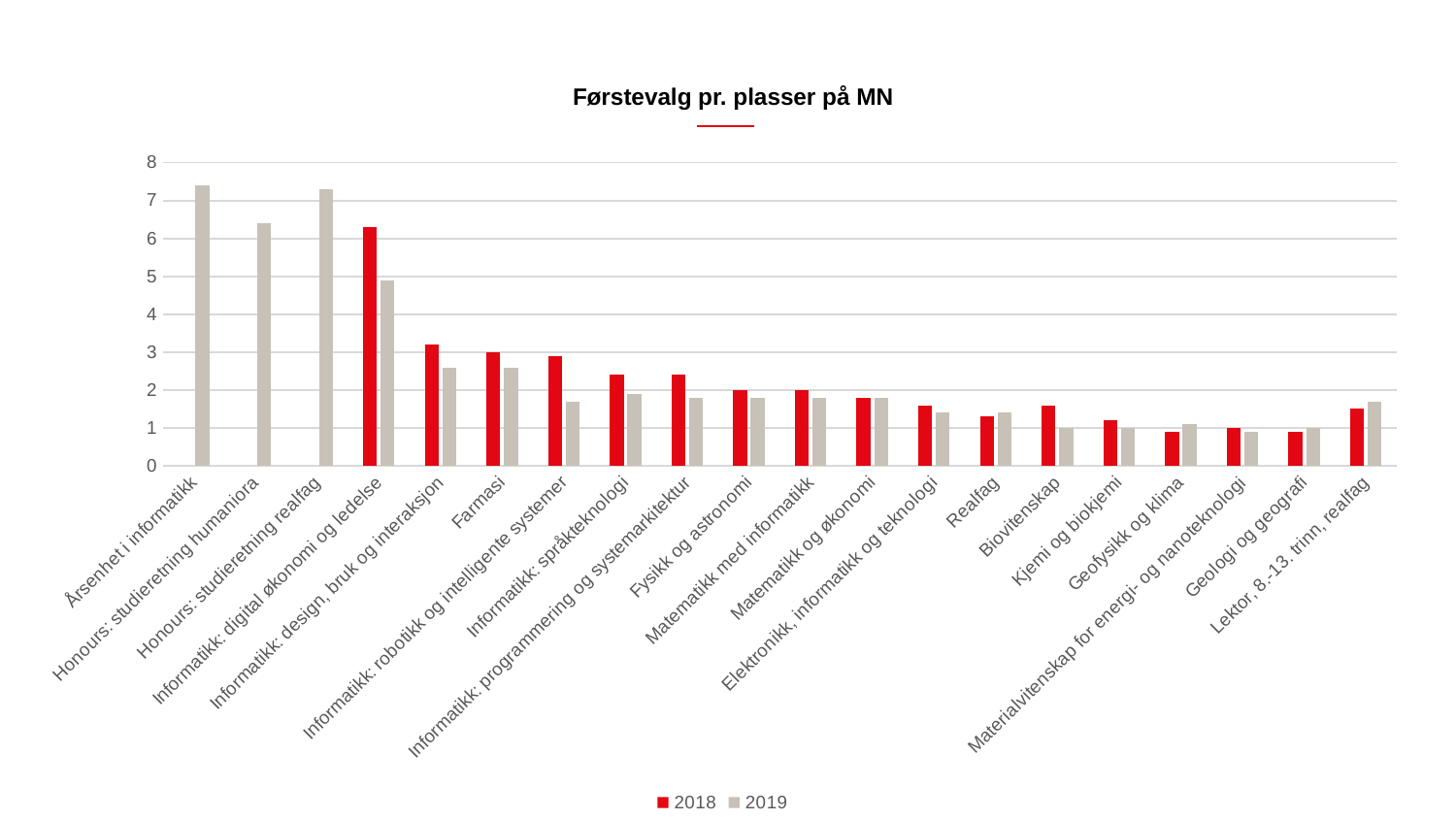
How many series does the legend list? 2 For Informatikk: robotikk og intelligente systemer, which year has the larger value, 2018 or 2019? 2018 Is the 2018 value for Informatikk: digital økonomi og ledelse greater or less than 6? greater Is the 2019 value for Årsenhet i informatikk greater or less than 7? greater For Lektor, 8.-13. trinn, realfag, which year has the larger value, 2018 or 2019? 2019 What is the title of the chart? Førstevalg pr. plasser på MN How many categories are shown on the x axis? 20 Which colour represents the 2018 series? red Which category has the highest value for 2018? Informatikk: digital økonomi og ledelse Is the 2019 value for Honours: studieretning humaniora greater or less than 6? greater What kind of chart is shown on the slide? bar chart